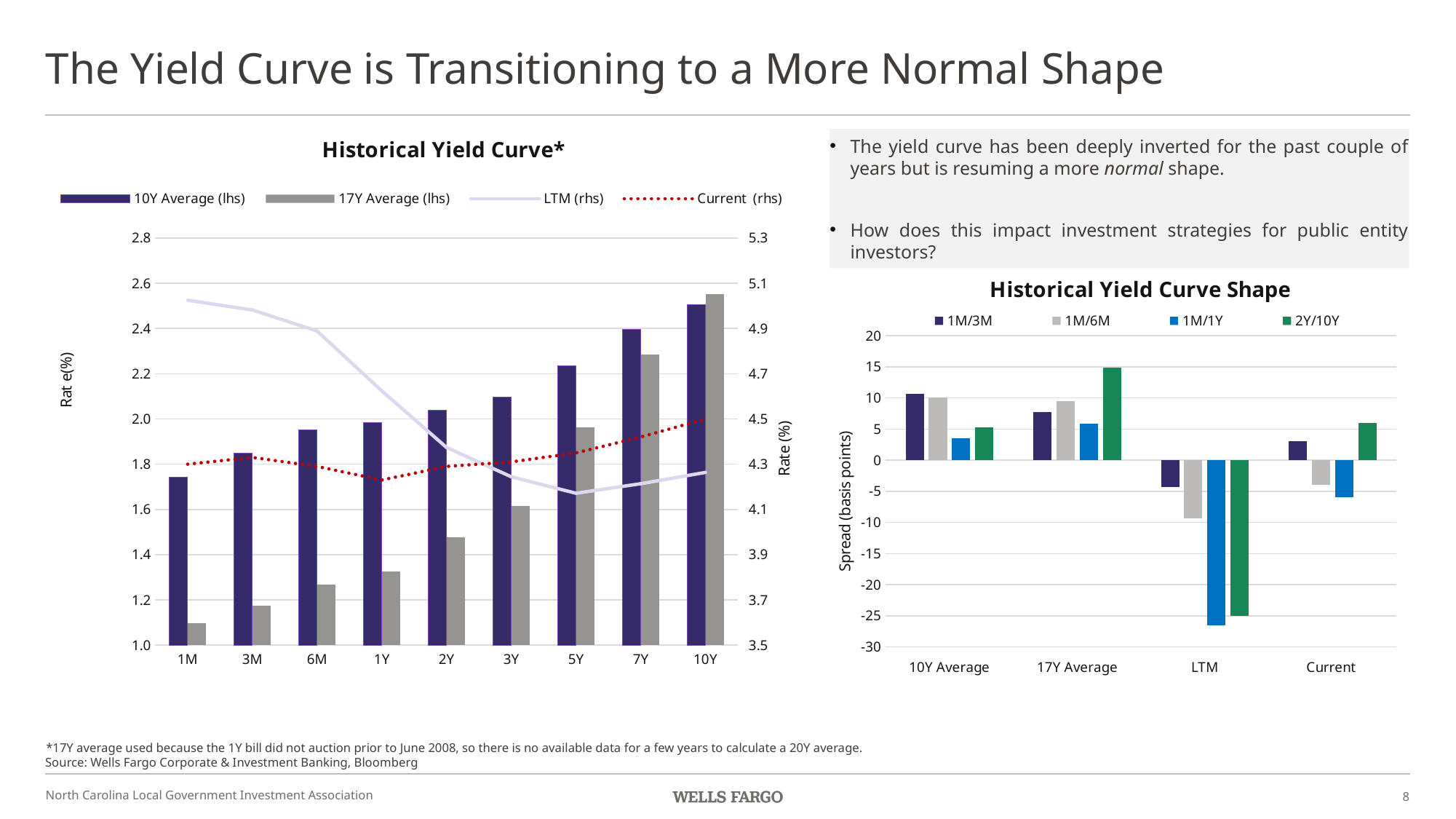
On the Historical Yield Curve chart, is the 17Y Average value for 10Y greater or less than 2.4? greater On the Historical Yield Curve Shape chart, for 10Y Average, which is larger: 1M/3M or 1M/1Y? 1M/3M On the Historical Yield Curve chart, do the 10Y Average bars rise or fall from 1M to 10Y? rise On the Historical Yield Curve chart, which series is drawn as a red dotted line? Current (rhs) On the Historical Yield Curve Shape chart, is the 2Y/10Y value for 17Y Average greater or less than 10? greater On the Historical Yield Curve chart, is the 10Y Average value for 1M greater or less than 1.8? less On the Historical Yield Curve Shape chart, how many series does the legend list? 4 On the Historical Yield Curve chart, which maturity has the lowest 17Y Average bar? 1M On the Historical Yield Curve chart, how many maturity categories are shown on the x axis? 9 On the Historical Yield Curve chart, how many series does the legend list? 4 What kind of chart is the Historical Yield Curve Shape chart? bar chart On the Historical Yield Curve chart, which maturity has the highest 10Y Average bar? 10Y